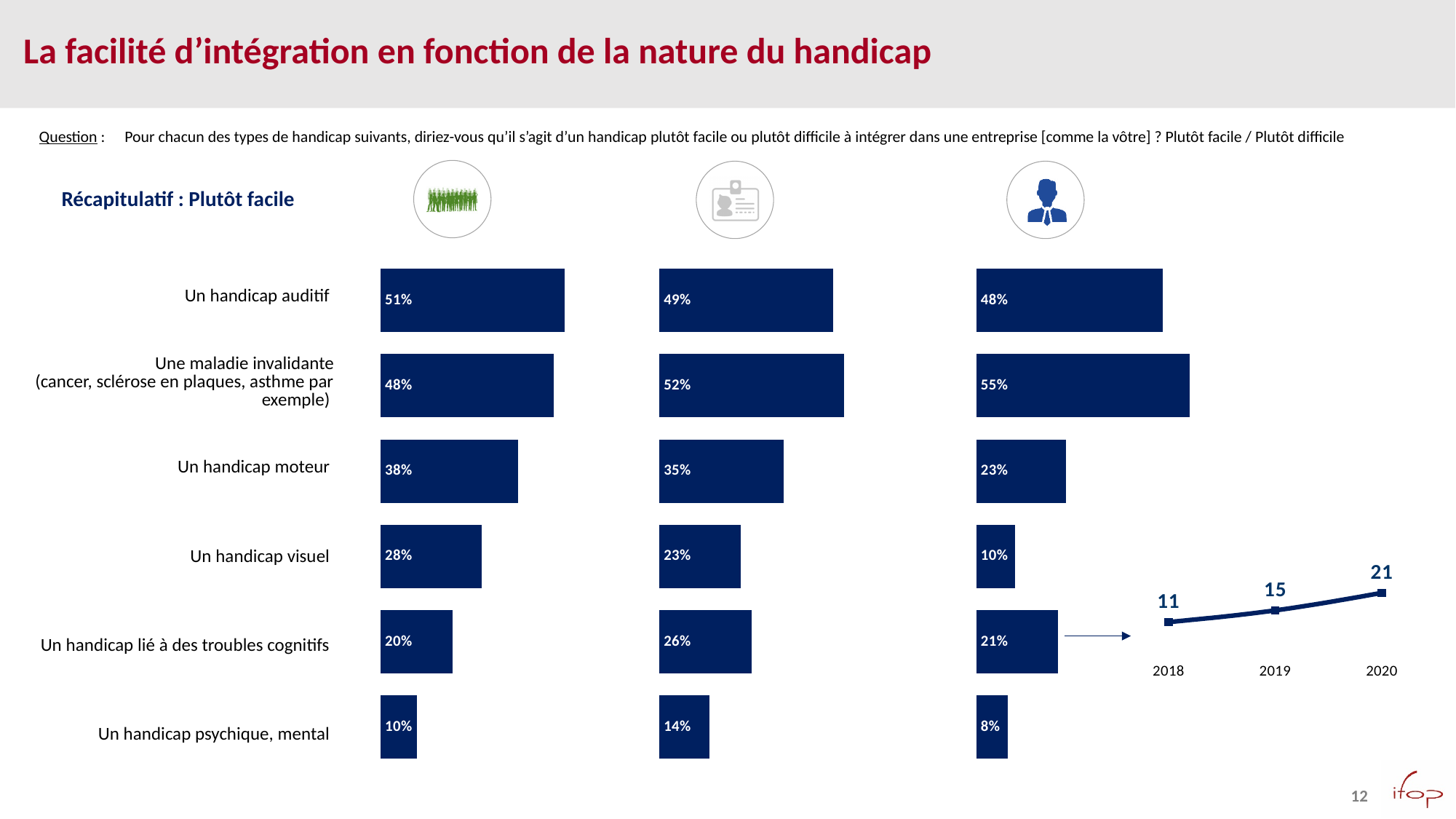
How many categories are shown in the left bar chart? 6 In the left bar chart, what is the value for 'Un handicap auditif'? 51% In the line chart at the bottom right, what is the value for 2020? 21 In the right bar chart, what is the value for 'Un handicap visuel'? 10% In the line chart at the bottom right, what is the difference between the 2020 and 2018 values? 10 In the middle bar chart, what is the value for 'Un handicap lié à des troubles cognitifs'? 26% In the middle bar chart, what is the difference between 'Un handicap auditif' and 'Un handicap moteur'? 14% In the right bar chart, which category has the highest value? Une maladie invalidante (cancer, sclérose en plaques, asthme par exemple) In the right bar chart, which is larger: 'Un handicap moteur' or 'Un handicap lié à des troubles cognitifs'? Un handicap moteur In the left bar chart, which category has the lowest value? Un handicap psychique, mental What kind of chart is the small chart at the bottom right with years 2018, 2019 and 2020? Line chart In the line chart at the bottom right, do the values rise or fall from 2018 to 2020? Rise